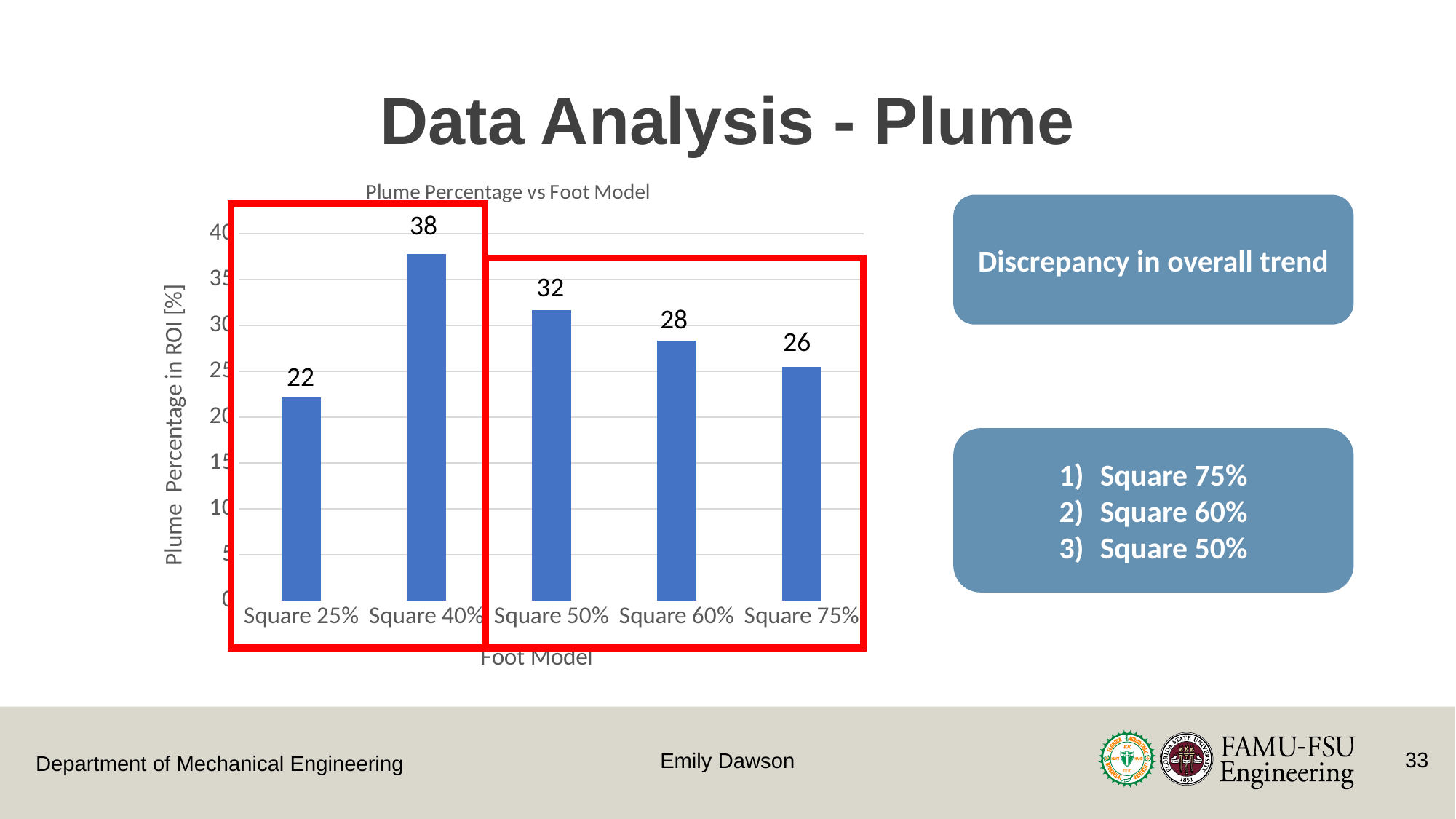
Which has a higher plume percentage, Square 50% or Square 60%? Square 50% What is the difference between the plume percentage for Square 50% and Square 75%? 6 Which foot model has the lowest plume percentage? Square 25% What is the plume percentage for Square 25%? 22 What is the difference between the plume percentage for Square 40% and Square 25%? 16 What is the title of the chart? Plume Percentage vs Foot Model What kind of chart is shown on the slide? bar chart How many foot models are shown on the x axis? 5 What is the plume percentage for Square 60%? 28 Which foot model has the highest plume percentage? Square 40% Is the value for Square 75% greater or less than 30? less What is the plume percentage for Square 40%? 38